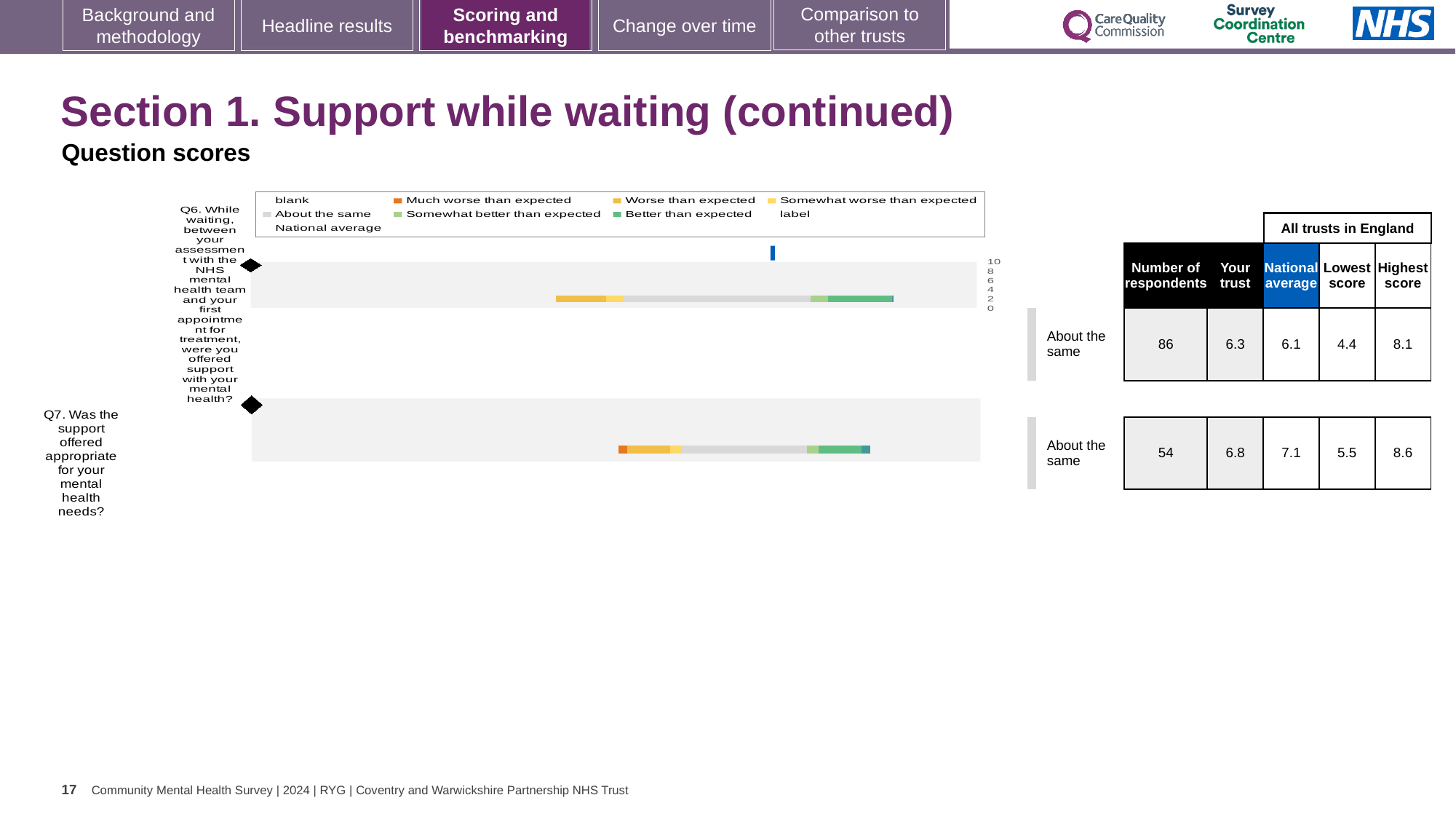
For Q7, which is higher: the trust's score or the national average? National average What benchmark category is shown for both Q6 and Q7? About the same What kind of chart is used to show the question scores on this slide? bar chart What is the national average score for Q7 (was the support offered appropriate for your mental health needs)? 7.1 What is the difference between the highest and lowest scores across all trusts in England for Q6? 3.7 What is the lowest score across all trusts in England for Q6? 4.4 What is the highest score across all trusts in England for Q7? 8.6 For Q6, which is higher: the trust's score or the national average? Your trust How many questions (bars) are plotted in the chart? 2 What is the 'Your trust' score for Q6 (support while waiting between assessment and first appointment)? 6.3 How many respondents answered Q6? 86 Which question had more respondents, Q6 or Q7? Q6